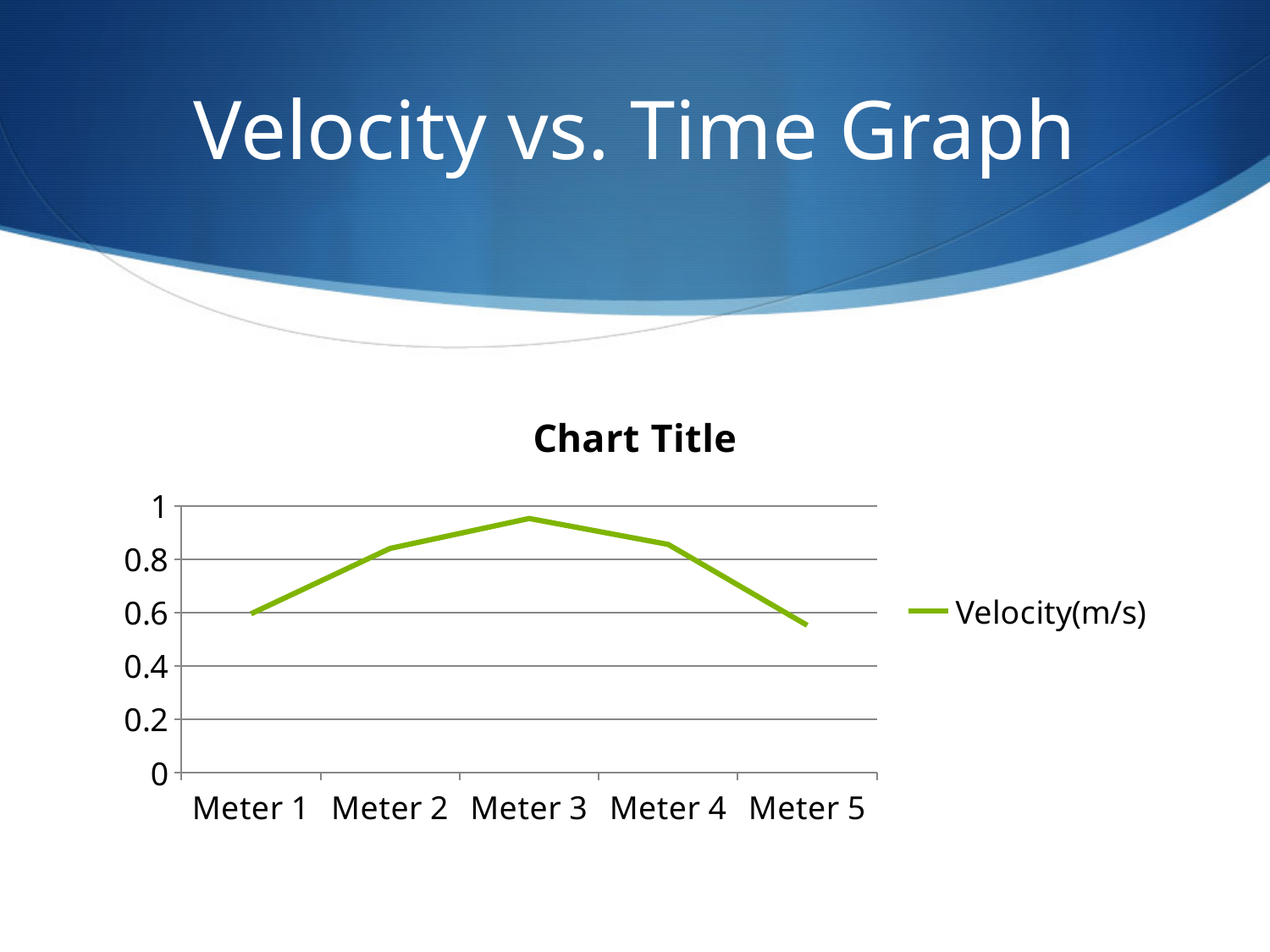
Is the value for Meter 2 greater or less than 0.8? greater Does the line rise or fall between Meter 3 and Meter 5? fall What kind of chart is shown on the slide? line chart What is the title shown above the chart? Chart Title How many categories are plotted along the x axis? 5 Is the value for Meter 3 greater or less than 0.8? greater Which is larger, the value for Meter 1 or the value for Meter 3? Meter 3 Is the value for Meter 5 greater or less than 0.6? less What series name appears in the legend? Velocity(m/s) Which category has the highest velocity value? Meter 3 How many series does the legend list? 1 Which category has the lowest velocity value? Meter 5